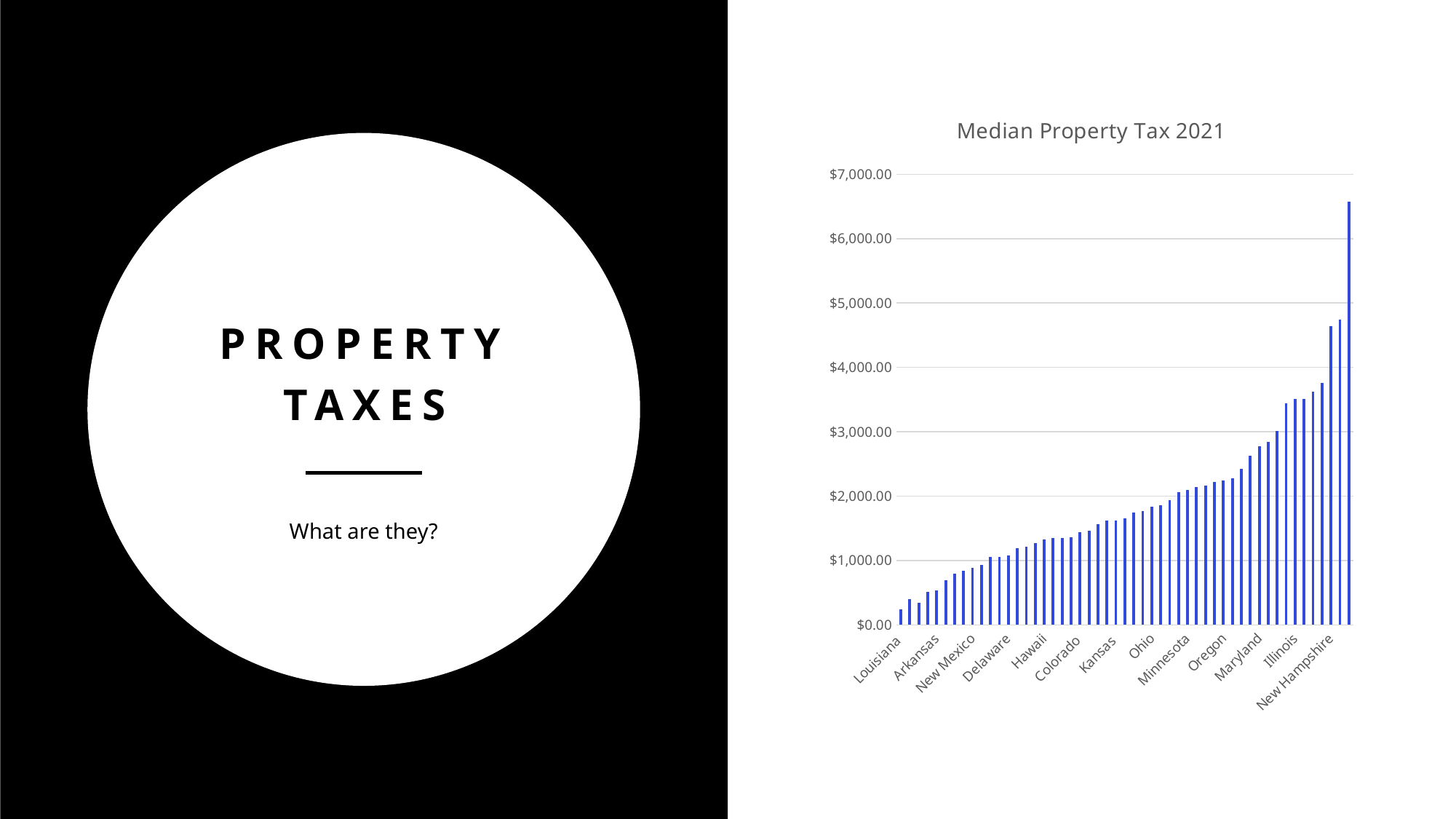
Is the value for Ohio greater or less than $1,000.00? greater What is the highest value shown on the vertical axis? $7,000.00 Is the value for Illinois greater or less than $3,000.00? greater What kind of chart is shown on the slide? bar chart Which has a higher median property tax, New Hampshire or Louisiana? New Hampshire Do the values generally rise or fall from left to right along the x axis? rise Is the value for Delaware greater or less than $2,000.00? less Which has a higher median property tax, Hawaii or Illinois? Illinois Which labelled state has the lowest median property tax in the chart? Louisiana What is the title of the chart? Median Property Tax 2021